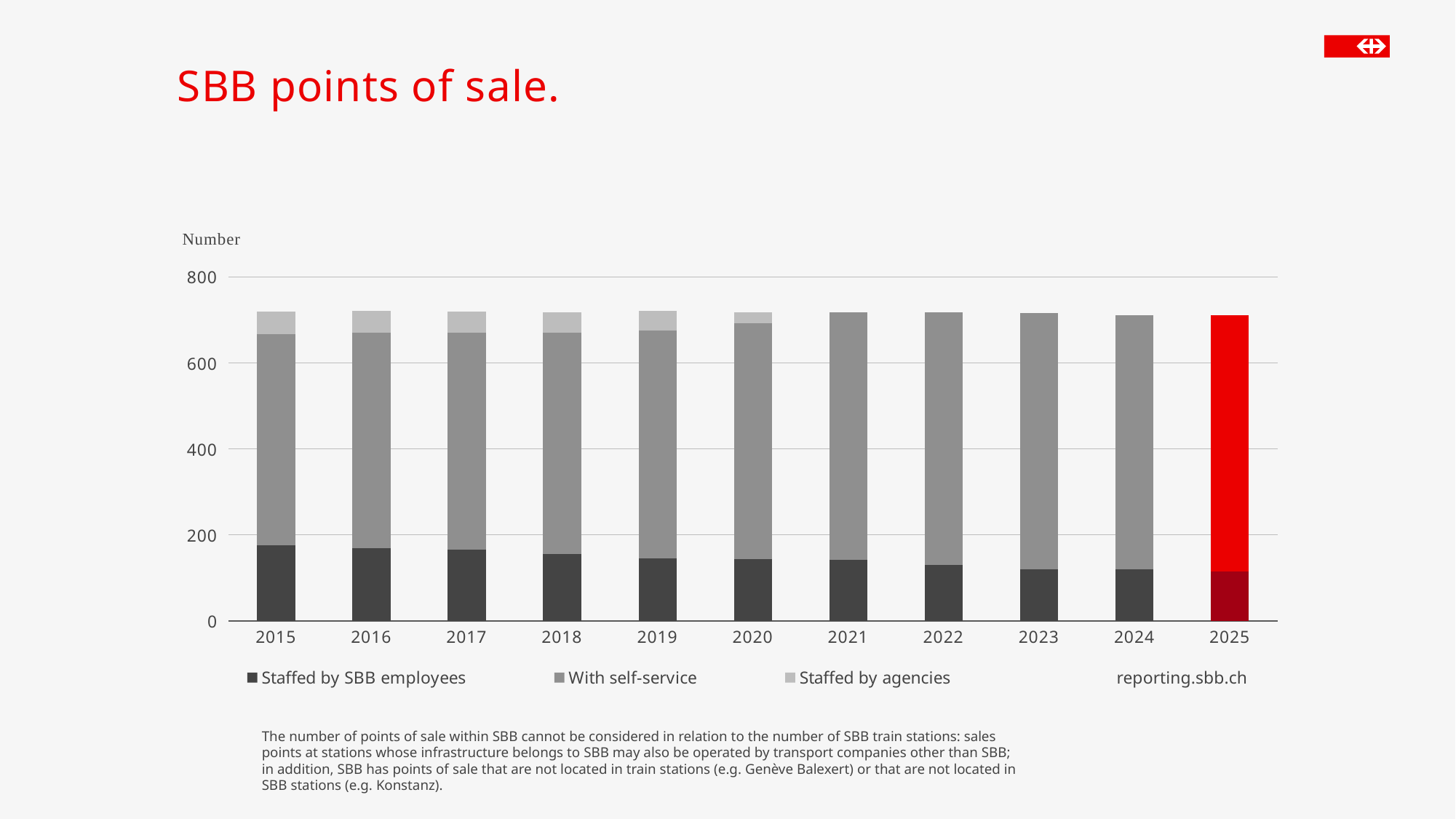
What is the title of the slide containing the chart? SBB points of sale. What kind of chart is shown on the slide? Stacked bar chart How many years are shown on the x axis of the chart? 11 Does the 'Staffed by SBB employees' segment rise or fall from 2015 to 2025? fall Is the total height of the stacked bar for 2025 greater or less than 600? greater Is the total height of the stacked bar for 2015 greater or less than 800? less Is the value for 'Staffed by SBB employees' in 2015 greater or less than 200? less Which year's bar is highlighted in red in the chart? 2025 Which is larger: the 'With self-service' value in 2015 or in 2021? 2021 Which is larger: the 'Staffed by SBB employees' value in 2015 or in 2025? 2015 How many series does the chart legend list? 3